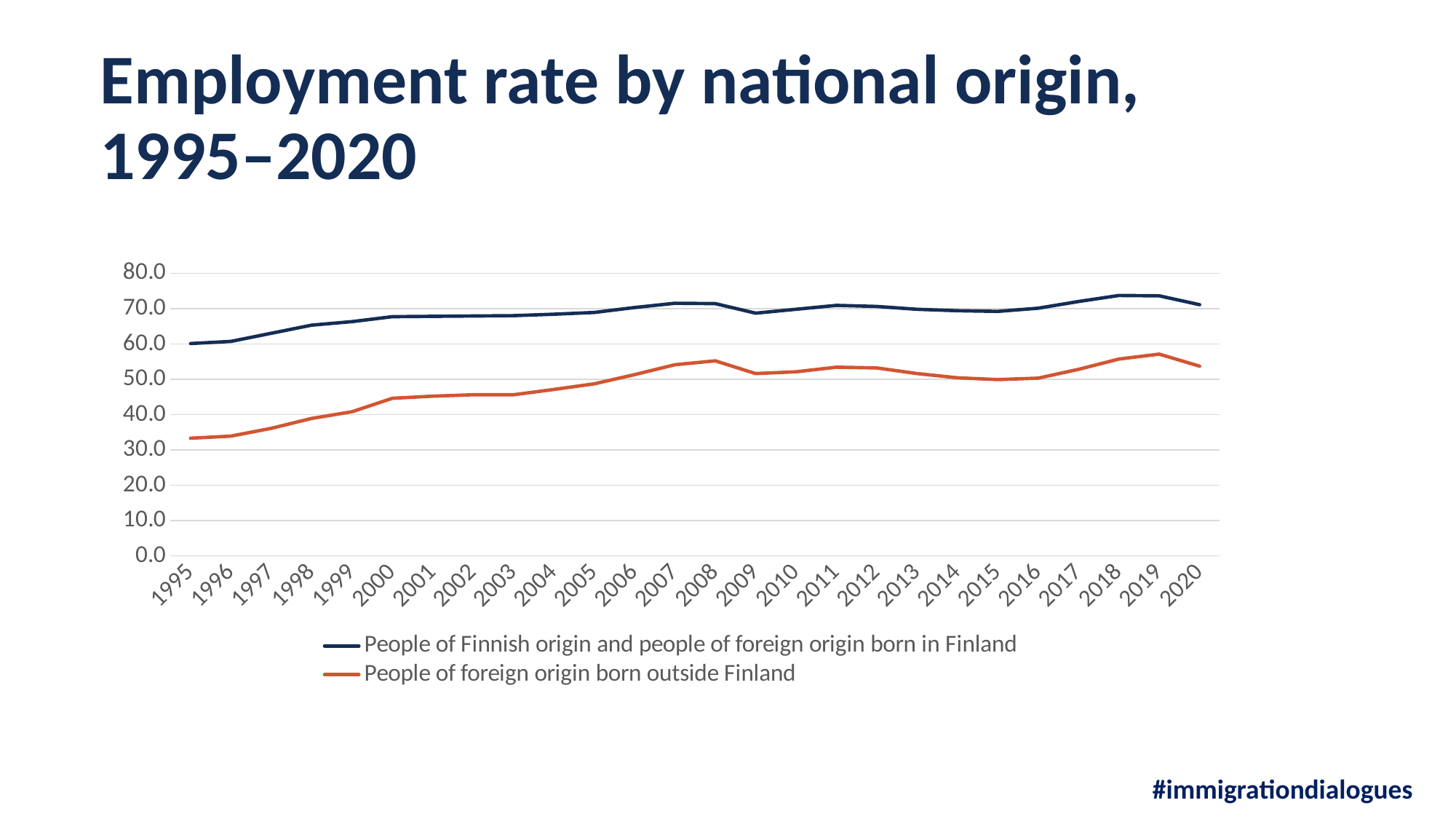
What is the title of the chart? Employment rate by national origin, 1995–2020 Is the value for People of Finnish origin and people of foreign origin born in Finland in 2019 greater or less than 70.0? greater Is the value for People of foreign origin born outside Finland in 2019 greater or less than 50.0? greater Is the value for People of foreign origin born outside Finland in 2008 greater or less than 50.0? greater What kind of chart is shown on the slide? line chart In 2010, which series has the higher employment rate? People of Finnish origin and people of foreign origin born in Finland In which year is the value for People of foreign origin born outside Finland lowest? 1995 How many years are plotted along the x axis? 26 Does the value for People of foreign origin born outside Finland rise or fall from 1995 to 2000? rise How many series does the legend list? 2